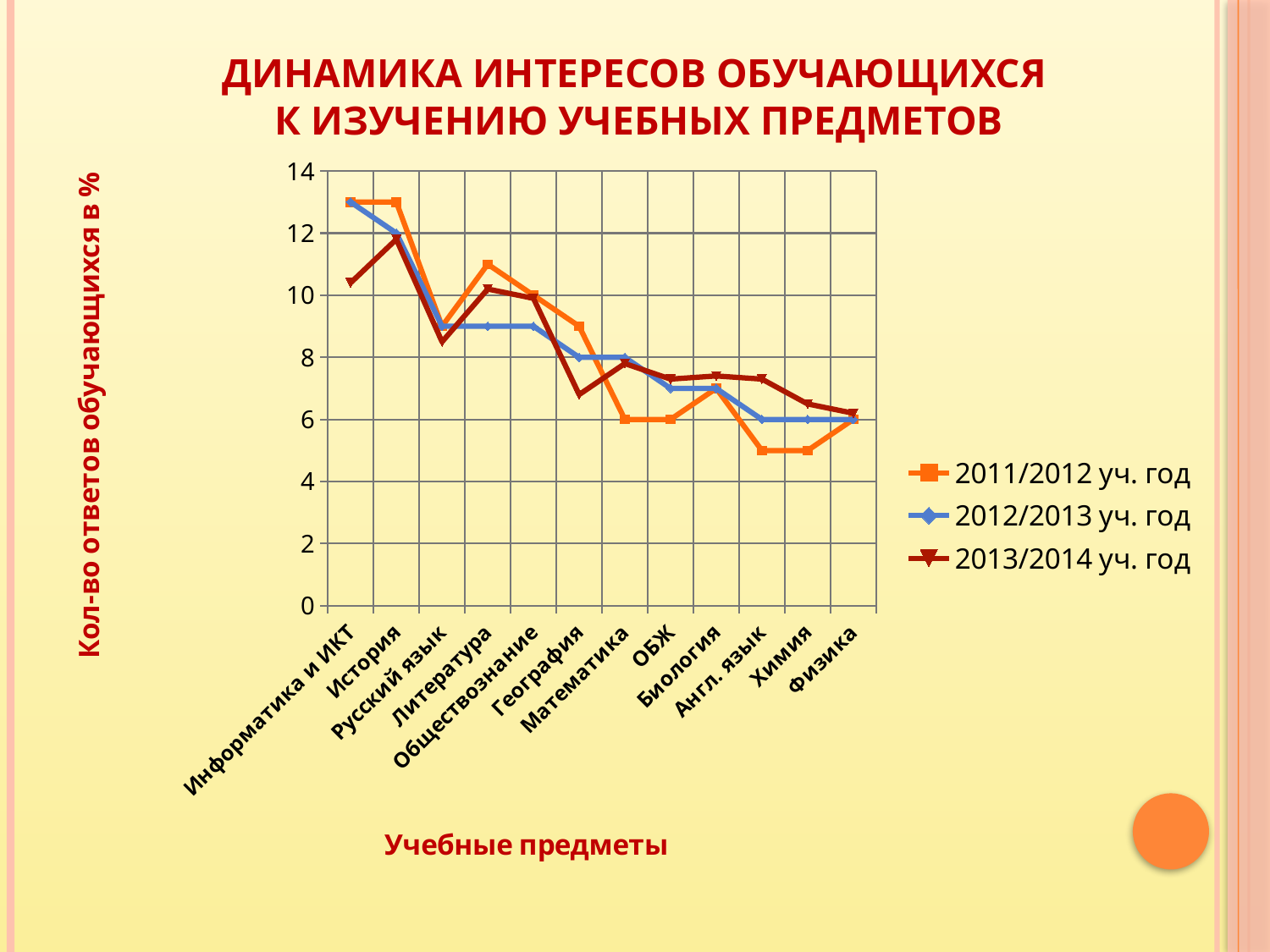
Is the value for Литература in the 2011/2012 уч. год series greater or less than 10? greater Is the value for Химия in the 2011/2012 уч. год series greater or less than 6? less Which subject has the highest value in the 2012/2013 уч. год series? Информатика и ИКТ What is the value for География in the 2012/2013 уч. год series? 8 How many series does the legend list? 3 Which subject has the highest value in the 2013/2014 уч. год series? История What is the value for История in the 2012/2013 уч. год series? 12 What kind of chart is shown on the slide? line chart How many school subjects are plotted along the x axis? 12 What is the value for Математика in the 2011/2012 уч. год series? 6 Do the values generally rise or fall from Информатика и ИКТ to Физика along the x axis? fall What is the value for Обществознание in the 2011/2012 уч. год series? 10